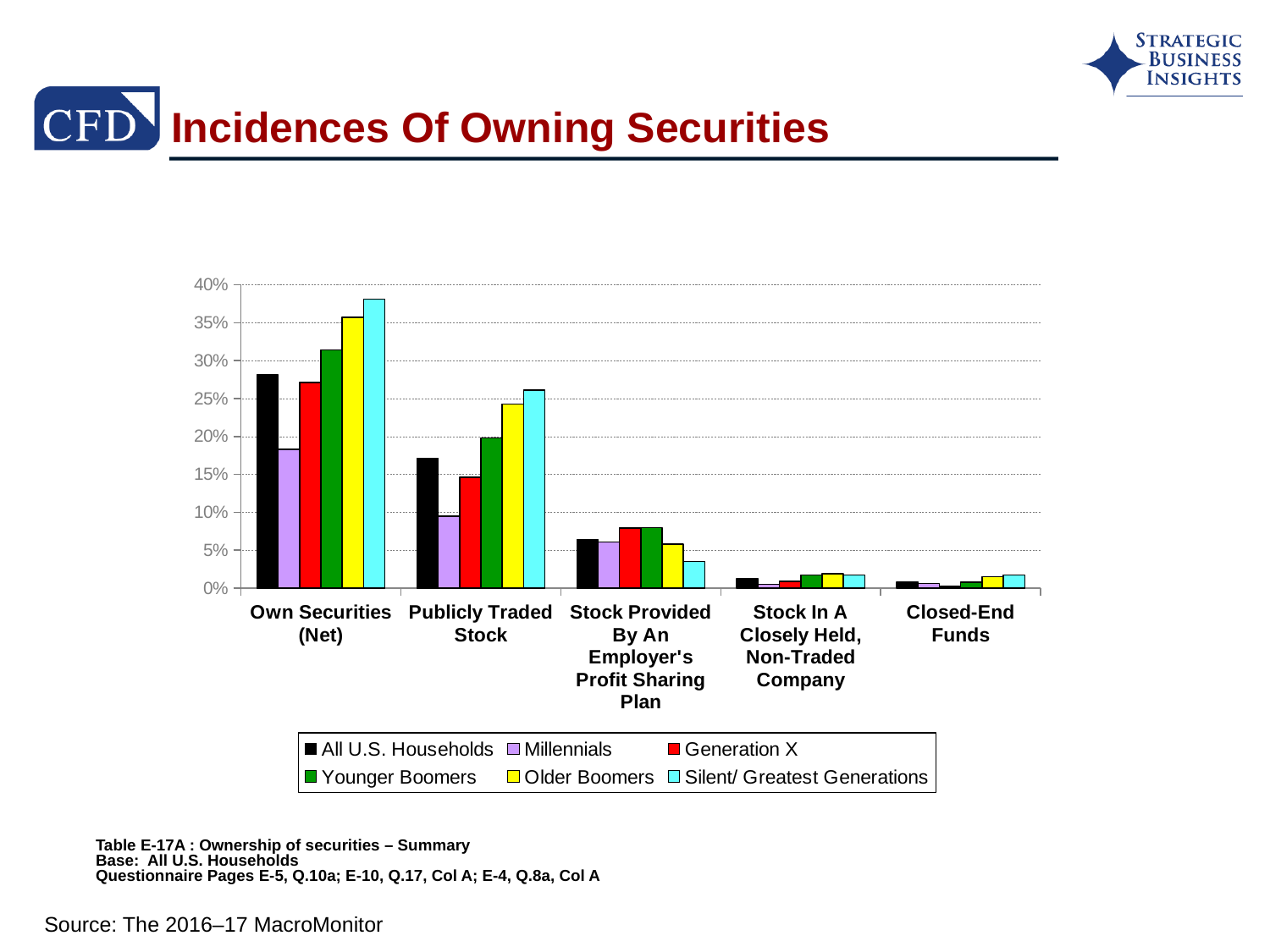
Which series has the highest value for Own Securities (Net)? Silent/ Greatest Generations What colour represents Generation X in the legend? Red Which category has the highest values overall in the chart? Own Securities (Net) How many categories are shown along the x axis of the chart? 5 Is the value for All U.S. Households in Own Securities (Net) greater or less than 25%? greater Is the value for Silent/ Greatest Generations in Own Securities (Net) greater or less than 35%? greater Which series has the lowest value for Own Securities (Net)? Millennials What kind of chart is shown on the slide? Bar chart How many series does the legend list? 6 For Publicly Traded Stock, which is larger: Older Boomers or Younger Boomers? Older Boomers Which series has the lowest value for Stock Provided By An Employer's Profit Sharing Plan? Silent/ Greatest Generations